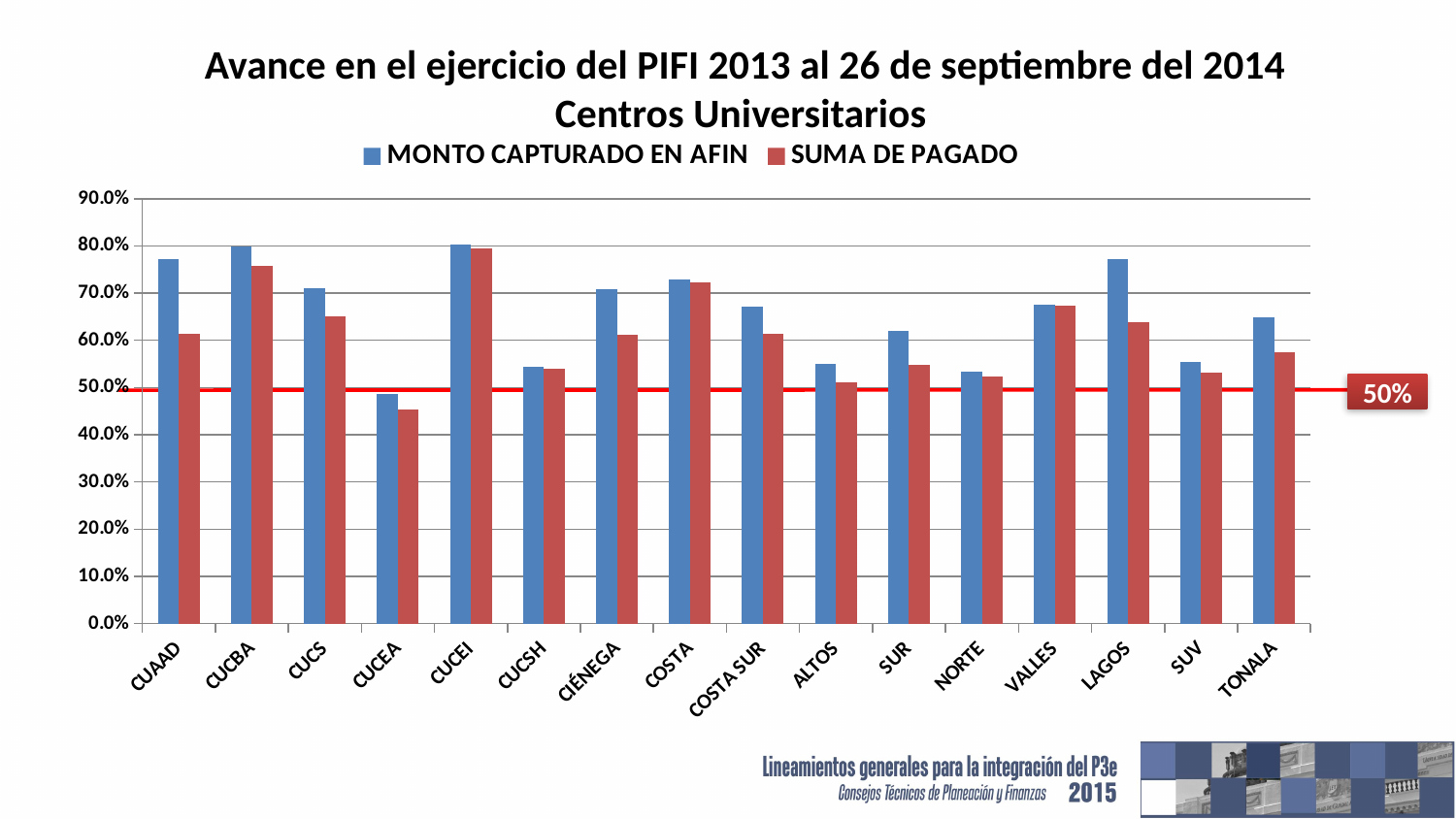
For LAGOS, which is larger: MONTO CAPTURADO EN AFIN or SUMA DE PAGADO? MONTO CAPTURADO EN AFIN How many series does the legend list? 2 What percentage does the red horizontal reference line mark? 50% Is the MONTO CAPTURADO EN AFIN value for SUR greater or less than 70%? less What kind of chart is shown on the slide? bar chart How many university centres (categories) are shown on the x axis? 16 Is the MONTO CAPTURADO EN AFIN value for CUCEA greater or less than 50%? less Which centre has the lowest MONTO CAPTURADO EN AFIN value? CUCEA Is the MONTO CAPTURADO EN AFIN value for CUAAD greater or less than 70%? greater Which centre has the highest SUMA DE PAGADO value? CUCEI Which centre has the lowest SUMA DE PAGADO value? CUCEA